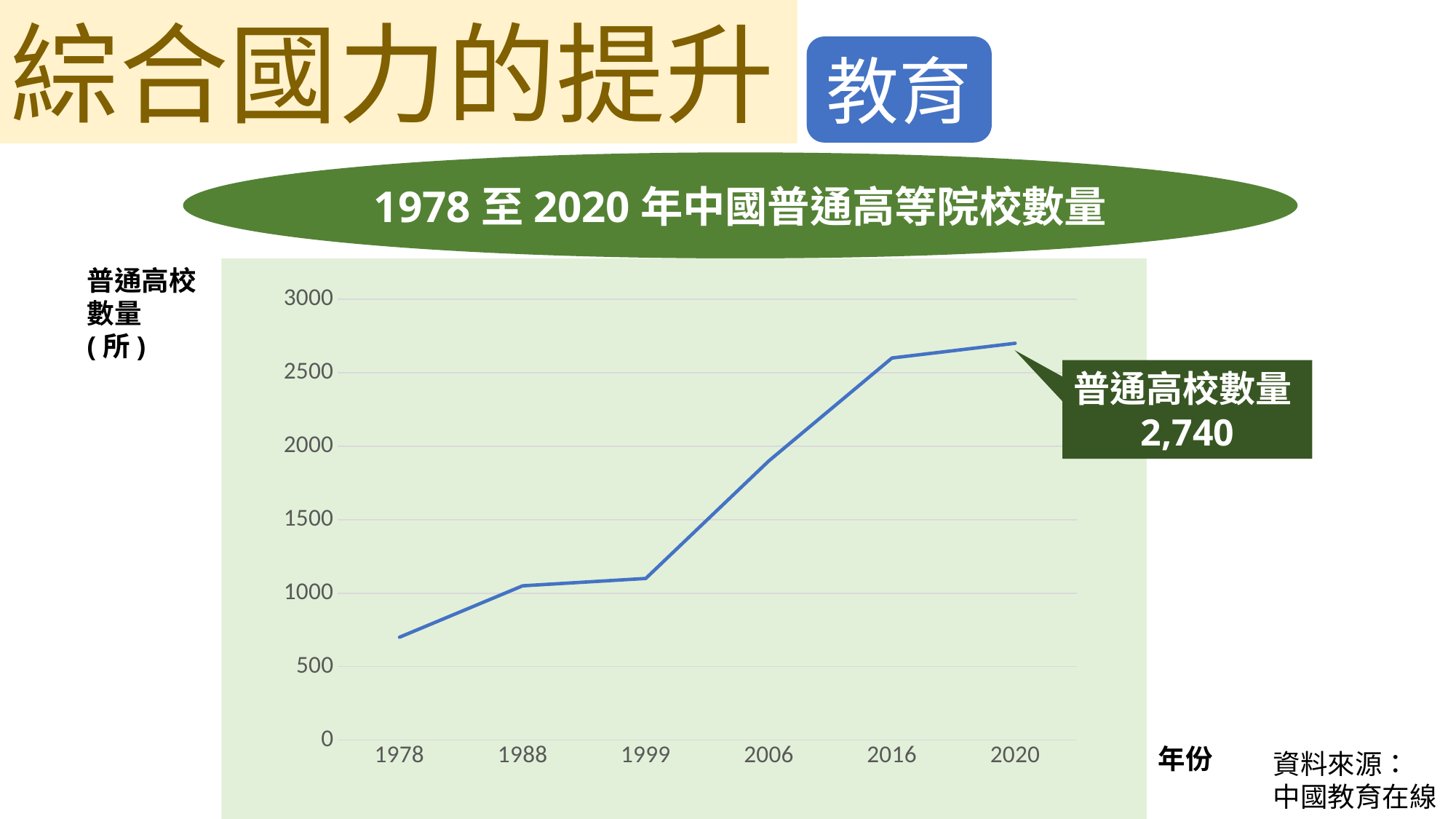
Is the value for 2016 greater or less than 2500? greater Does the number of 普通高校 rise or fall from 1978 to 2020? rise How many years are plotted on the x axis? 6 Is the value for 1978 greater or less than 1000? less Is the value for 2006 greater or less than 1500? greater What type of chart is shown on the slide? line chart What is the title of the chart? 1978 至 2020 年中國普通高等院校數量 What is the number of 普通高校 in 2020 according to the data label? 2,740 Which year has the highest number of 普通高校 on the chart? 2020 Which year has a larger value, 1988 or 2016? 2016 Which year has the lowest number of 普通高校 on the chart? 1978